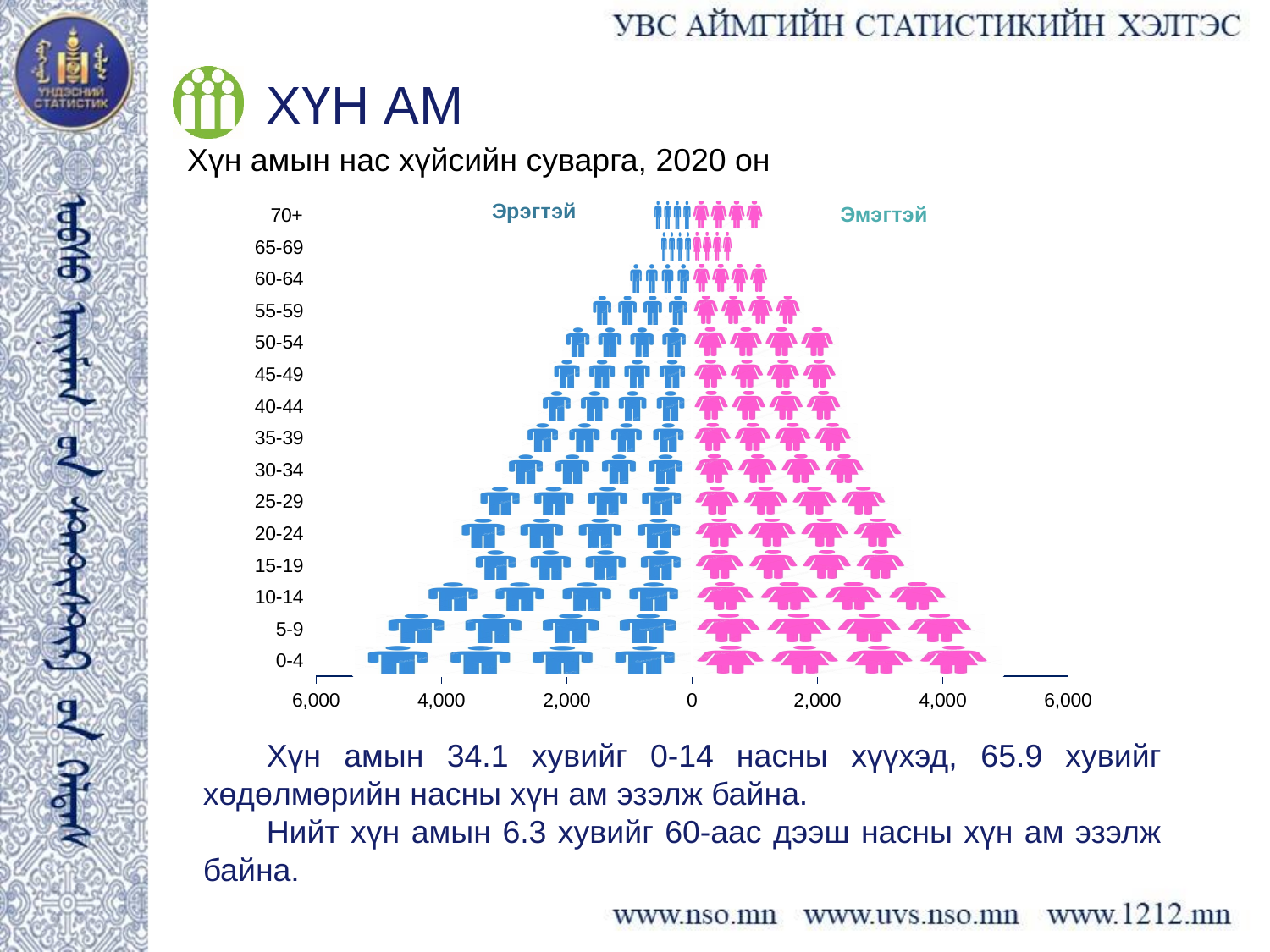
What is the title of the chart on the slide? Хүн амын нас хүйсийн суварга, 2020 он How many series (sexes) does the population pyramid show? 2 Which age group has the largest population for Эрэгтэй (male)? 0-4 How many age groups are shown on the vertical axis of the population pyramid? 15 Which is larger for the 0-4 age group, the Эрэгтэй (male) value or the Эмэгтэй (female) value? Эрэгтэй (male) Which age group has the smallest population for Эмэгтэй (female)? 65-69 What kind of chart is shown on the slide? bar chart (population pyramid) Is the Эрэгтэй (male) value for the 15-19 age group greater or less than 4,000? less Is the Эмэгтэй (female) value for the 60-64 age group greater or less than 2,000? less Moving from the 0-4 age group up to the 70+ age group, do the population values generally rise or fall? fall What are the two series labels shown on the population pyramid? Эрэгтэй and Эмэгтэй Is the Эрэгтэй (male) value for the 0-4 age group greater or less than 4,000? greater